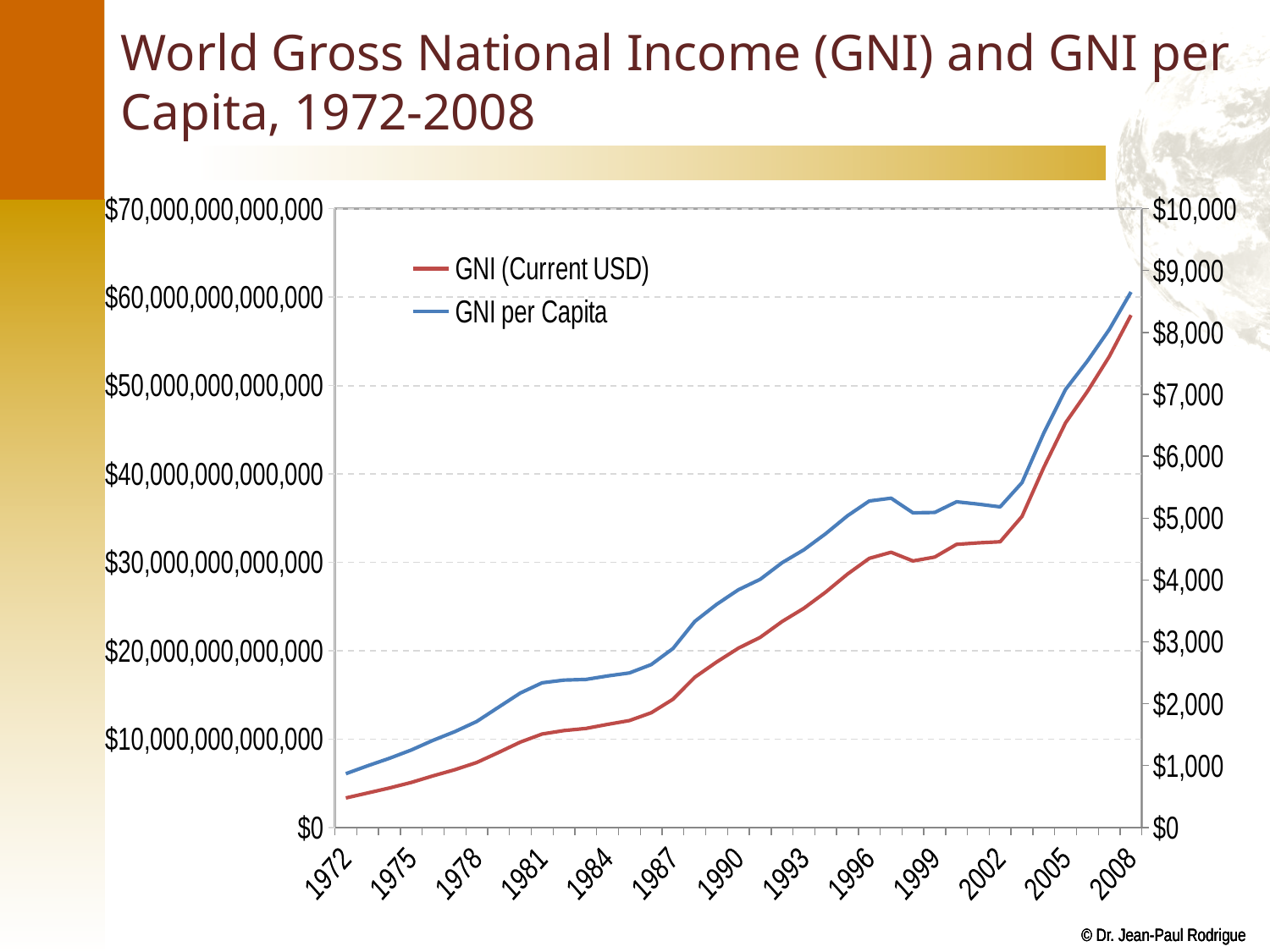
What colour is the line for GNI per Capita? Blue Is the value for GNI (Current USD) in 1999 greater or less than $40,000,000,000,000? less What are the two series named in the legend? GNI (Current USD) and GNI per Capita In which year is GNI (Current USD) highest? 2008 In which year is GNI per Capita lowest? 1972 Is the value for GNI per Capita in 2008 greater or less than $8,000? greater Is the value for GNI (Current USD) in 2008 greater or less than $50,000,000,000,000? greater What kind of chart is shown on the slide? Line chart How many year labels are shown along the x axis? 13 Overall, does the GNI (Current USD) line rise or fall from 1972 to 2008? Rise How many series does the legend list? 2